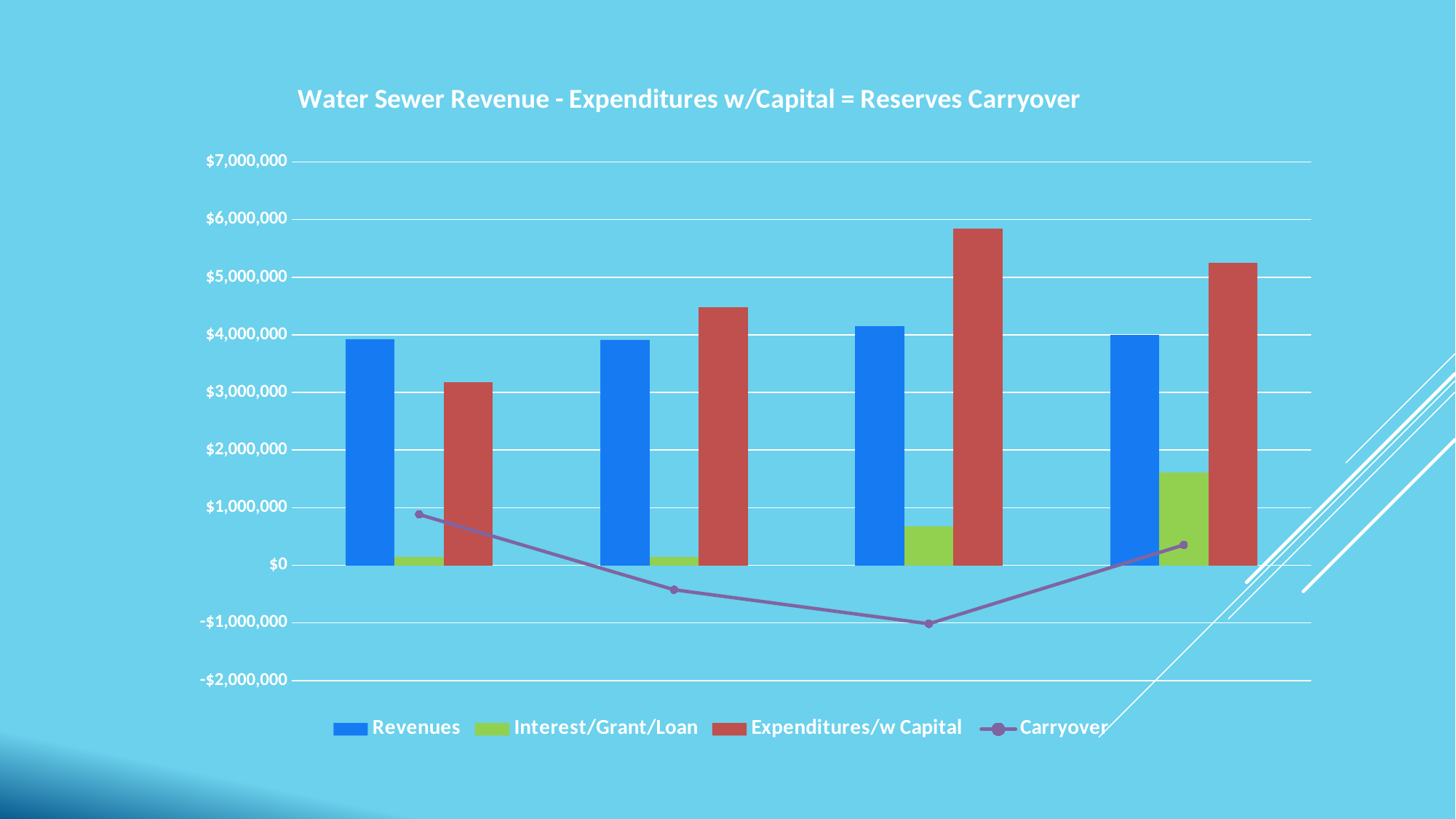
How many series does the legend list? 4 Which series is drawn as a line rather than bars? Carryover How many groups of bars are plotted along the x axis? 4 In which group of bars (counting from the left) is the Interest/Grant/Loan bar the tallest? Fourth Is the Expenditures/w Capital value in the third group from the left greater or less than $5,000,000? greater What is the title of the chart? Water Sewer Revenue - Expenditures w/Capital = Reserves Carryover What kind of chart is this? Bar chart with a line series In which group of bars (counting from the left) is the Expenditures/w Capital bar the tallest? Third At which point (counting from the left) is the Carryover line at its lowest? Third Is the Expenditures/w Capital value in the second group from the left greater or less than $4,000,000? greater Is the Carryover value at the second point from the left greater or less than $0? less In the first group from the left, which is larger: Revenues or Expenditures/w Capital? Revenues